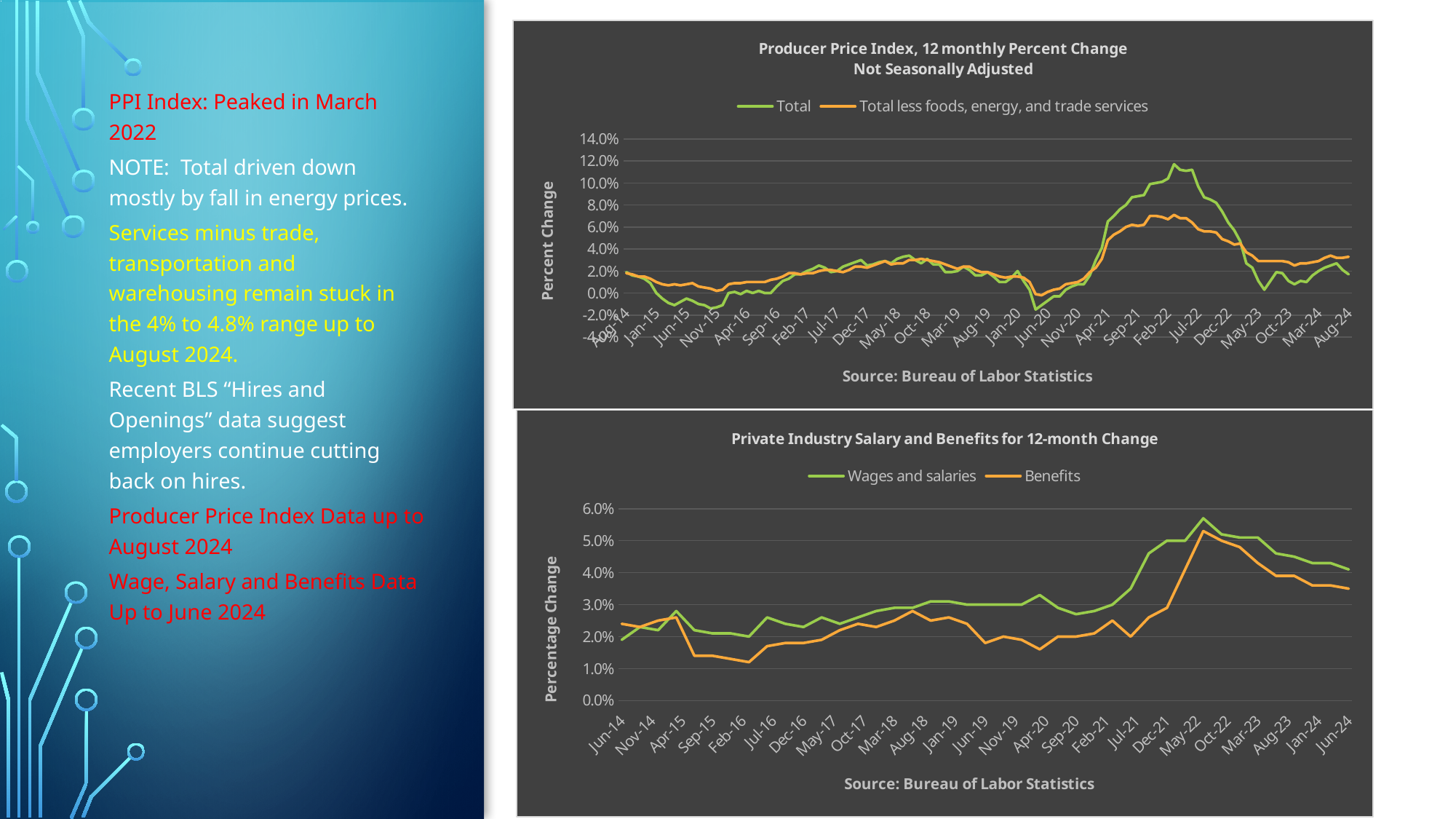
In the top chart (Producer Price Index), what are the two series named in the legend? Total; Total less foods, energy, and trade services How many series does the legend of the bottom chart (Private Industry Salary and Benefits) list? 2 In the bottom chart (Private Industry Salary and Benefits), is the value of Wages and salaries at May-22 greater or less than 5.0%? greater In the bottom chart (Private Industry Salary and Benefits), does the Wages and salaries series rise or fall from May-22 to Jun-24? Fall How many series does the legend of the top chart (Producer Price Index) list? 2 In the top chart (Producer Price Index), is the value of the Total series at Jun-20 greater or less than 0.0%? less In the bottom chart (Private Industry Salary and Benefits), is the value of Benefits at Feb-16 greater or less than 2.0%? less What kind of chart is the top chart, 'Producer Price Index, 12 monthly Percent Change Not Seasonally Adjusted'? Line chart What kind of chart is the bottom chart, 'Private Industry Salary and Benefits for 12-month Change'? Line chart In the top chart (Producer Price Index), at Feb-22, which series is higher: Total or Total less foods, energy, and trade services? Total In the bottom chart (Private Industry Salary and Benefits), what is the y-axis title? Percentage Change